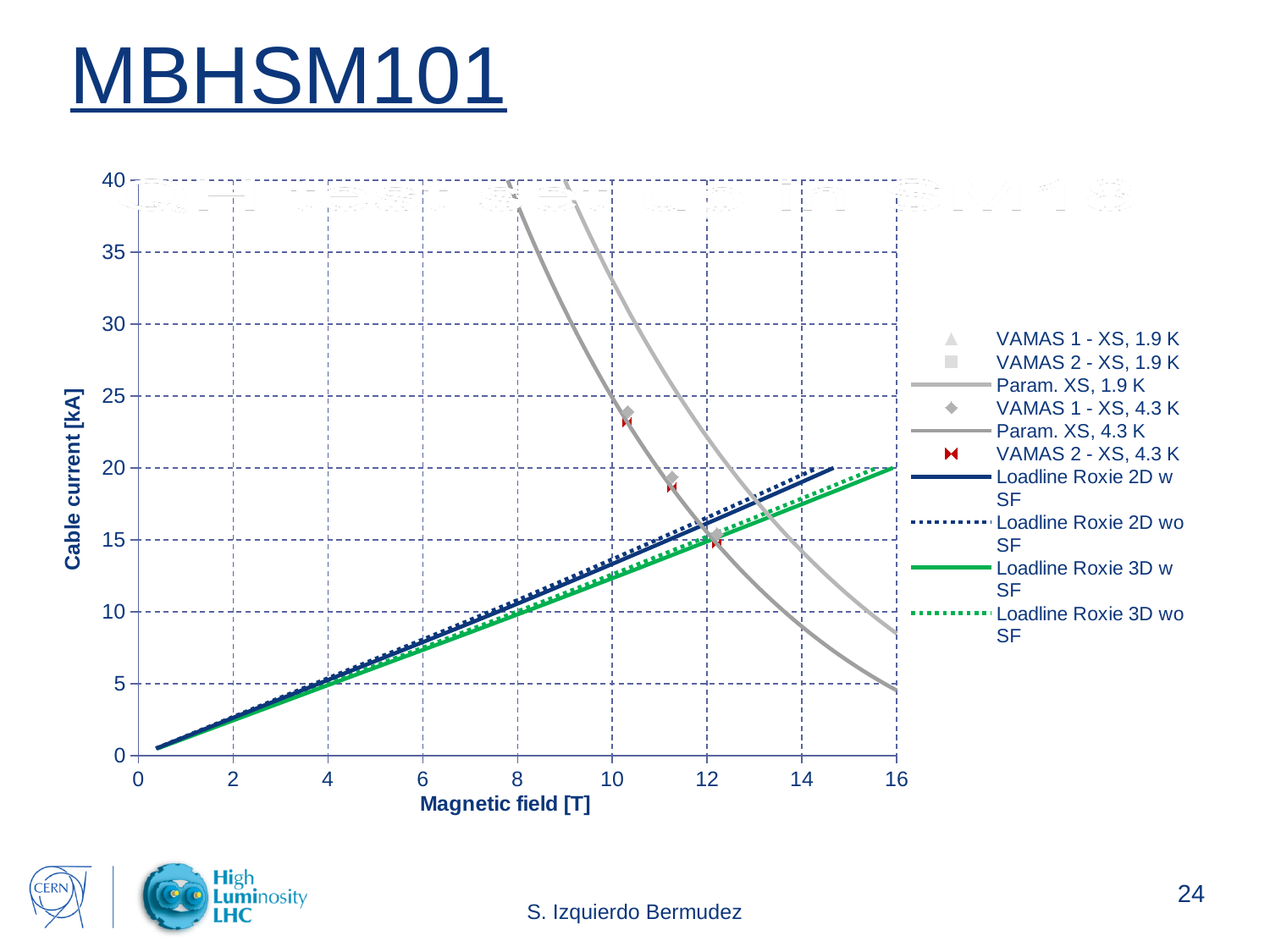
What kind of chart is shown on the slide? line chart Does the Param. XS, 4.3 K curve rise or fall as the magnetic field increases? fall Is the value of Param. XS, 1.9 K at 16 T greater or less than 10 kA? less What is the label of the y axis of the chart? Cable current [kA] Is the value of Param. XS, 4.3 K at 10 T greater or less than 20 kA? greater What is the label of the x axis of the chart? Magnetic field [T] Do the Loadline Roxie series rise or fall as the magnetic field increases? rise Is the value of Loadline Roxie 2D w SF at 10 T greater or less than 15 kA? less At 10 T, which is higher: Loadline Roxie 2D w SF or Loadline Roxie 3D w SF? Loadline Roxie 2D w SF How many series does the chart legend list? 10 What is the highest value shown on the y axis of the chart? 40